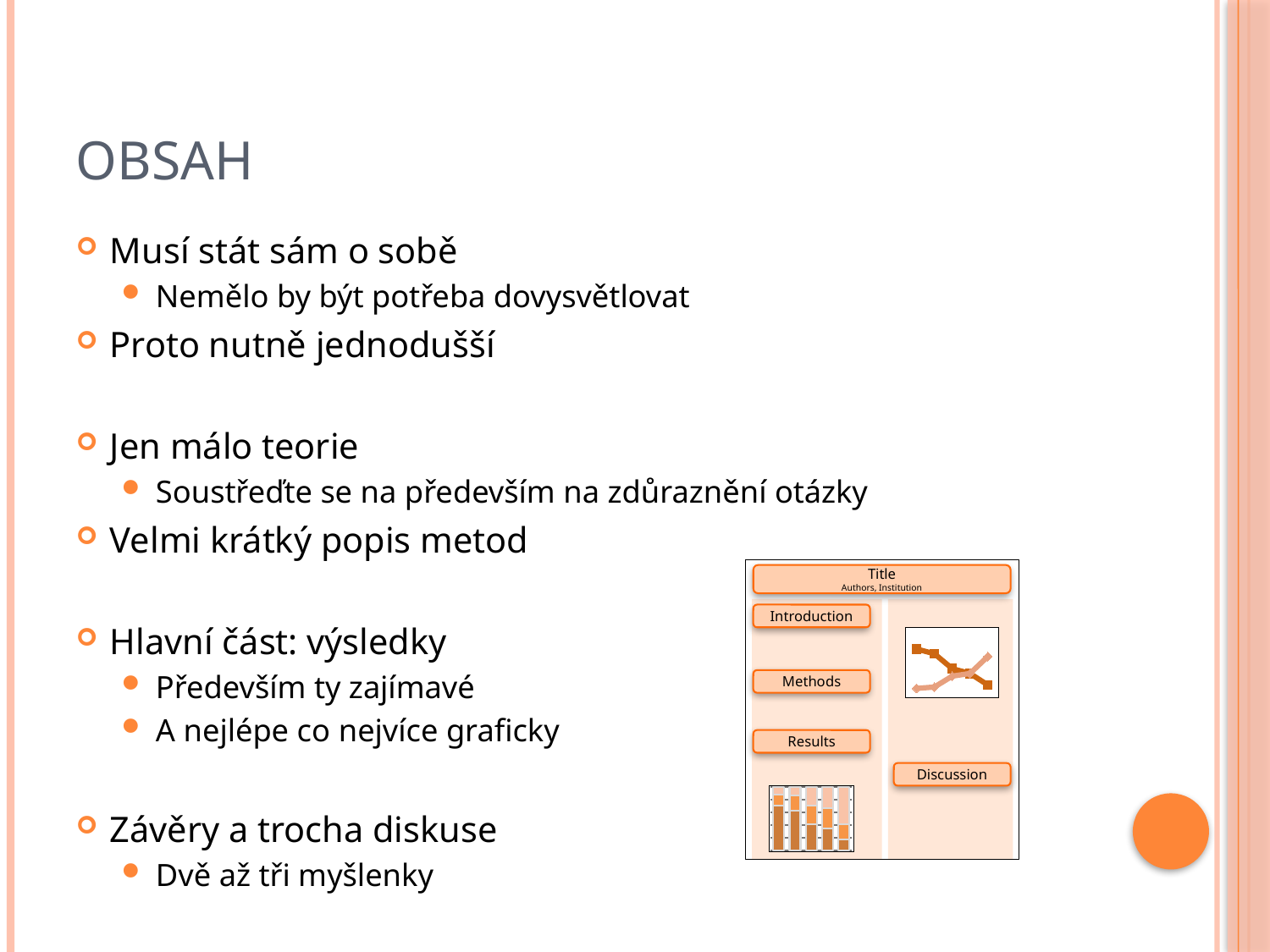
In the line chart of the poster mockup, how many lines are plotted? 2 In the line chart of the poster mockup, does the light pink line rise or fall from left to right? rise In the poster mockup on the right, what kind of chart is shown in the upper chart next to the Methods box? line chart In the bar chart of the poster mockup, are the bars stacked? yes In the bar chart of the poster mockup, are the bars vertical or horizontal? vertical In the poster mockup on the right, what kind of chart is shown in the lower chart below the Results box? bar chart In the line chart of the poster mockup, does the dark orange line rise or fall from left to right? fall